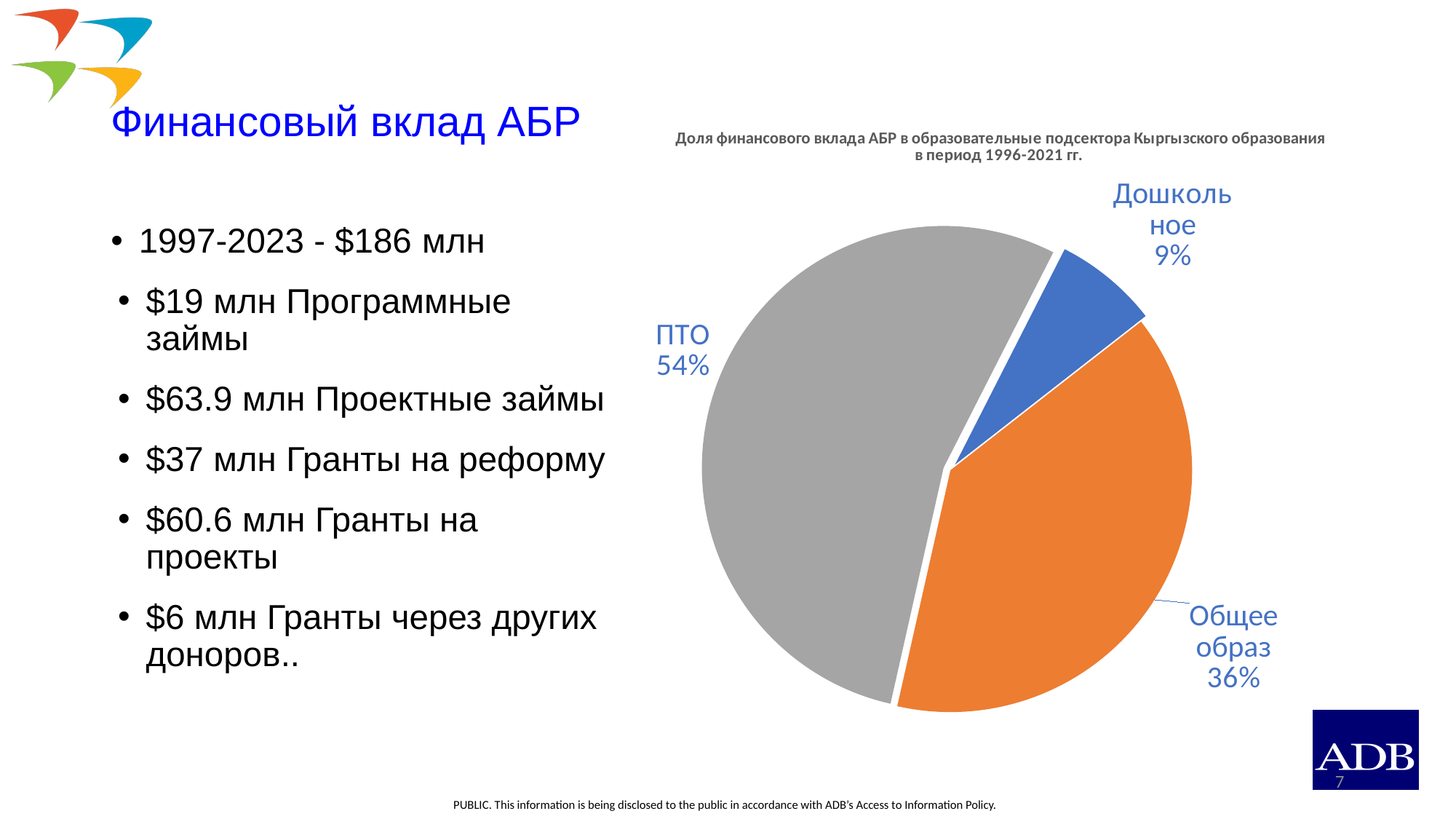
What share of the pie does Общее образ hold? 36% What is the difference in percentage points between the ПТО and Общее образ slices? 18 What is the difference in percentage points between the Общее образ and Дошкольное slices? 27 What share of the pie does ПТО hold? 54% What kind of chart is shown on the slide? pie chart Which slice of the pie is the largest? ПТО What colour is the ПТО slice? grey What period does the chart title say the data covers? 1996-2021 гг. How many slices does the pie chart have? 3 Which is larger, the Общее образ slice or the Дошкольное slice? Общее образ Which slice of the pie is the smallest? Дошкольное What share of the pie does Дошкольное hold? 9%